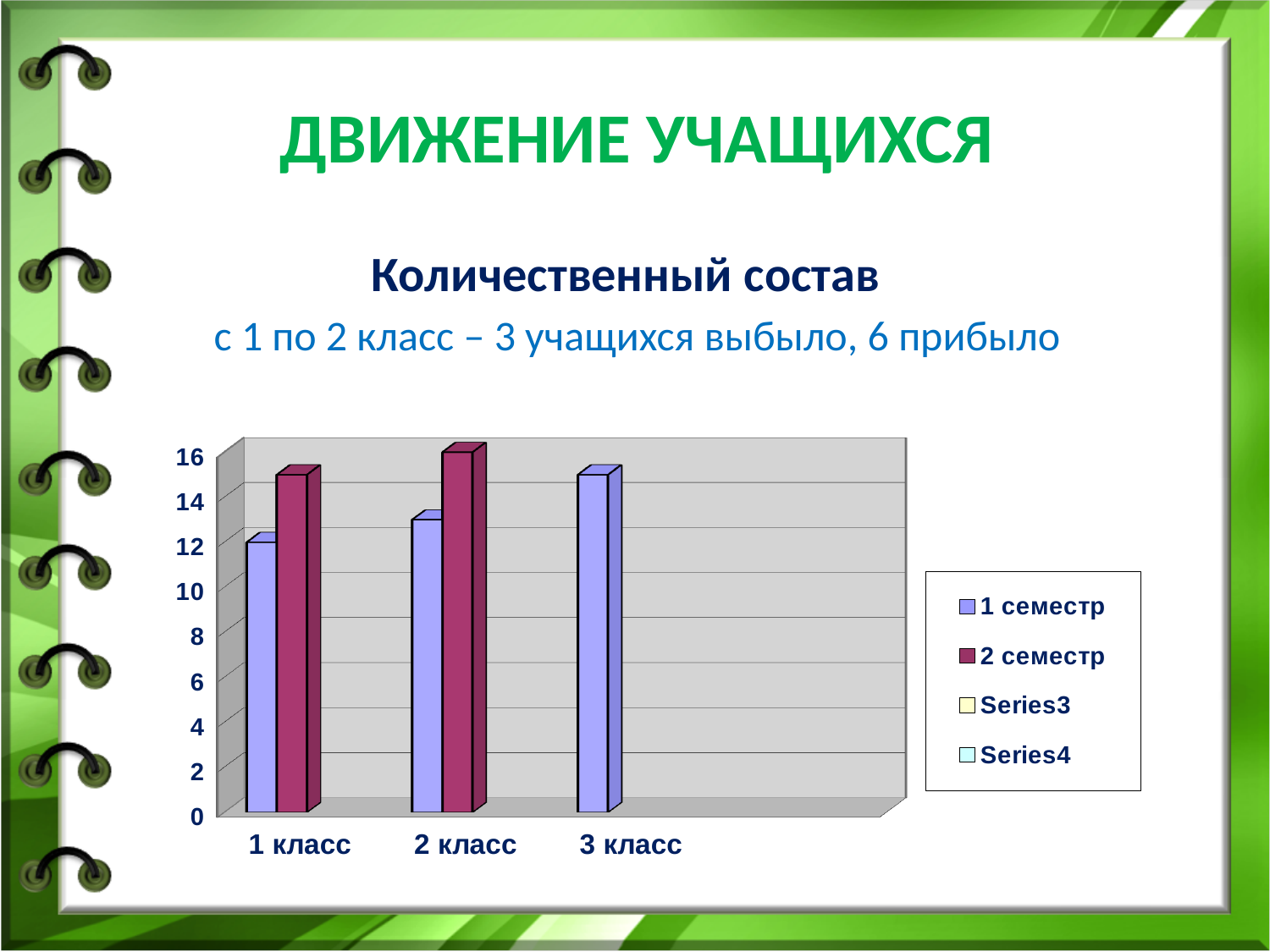
How many series does the chart legend list? 4 Is the value of 1 семестр for 1 класс greater or less than 14? less What kind of chart is shown on the slide? bar chart Do the 1 семестр values rise or fall from 1 класс to 3 класс? rise How many categories are shown on the x axis of the chart? 3 Which category has no 2 семестр bar in the chart? 3 класс For 2 класс, which is larger: 1 семестр or 2 семестр? 2 семестр Is the value of 1 семестр for 3 класс greater or less than 14? greater Which bar is the lowest in the chart? 1 семестр for 1 класс For 1 класс, which is larger: 1 семестр or 2 семестр? 2 семестр Is the value of 2 семестр for 2 класс greater or less than 14? greater Which category has the highest bar in the chart? 2 класс